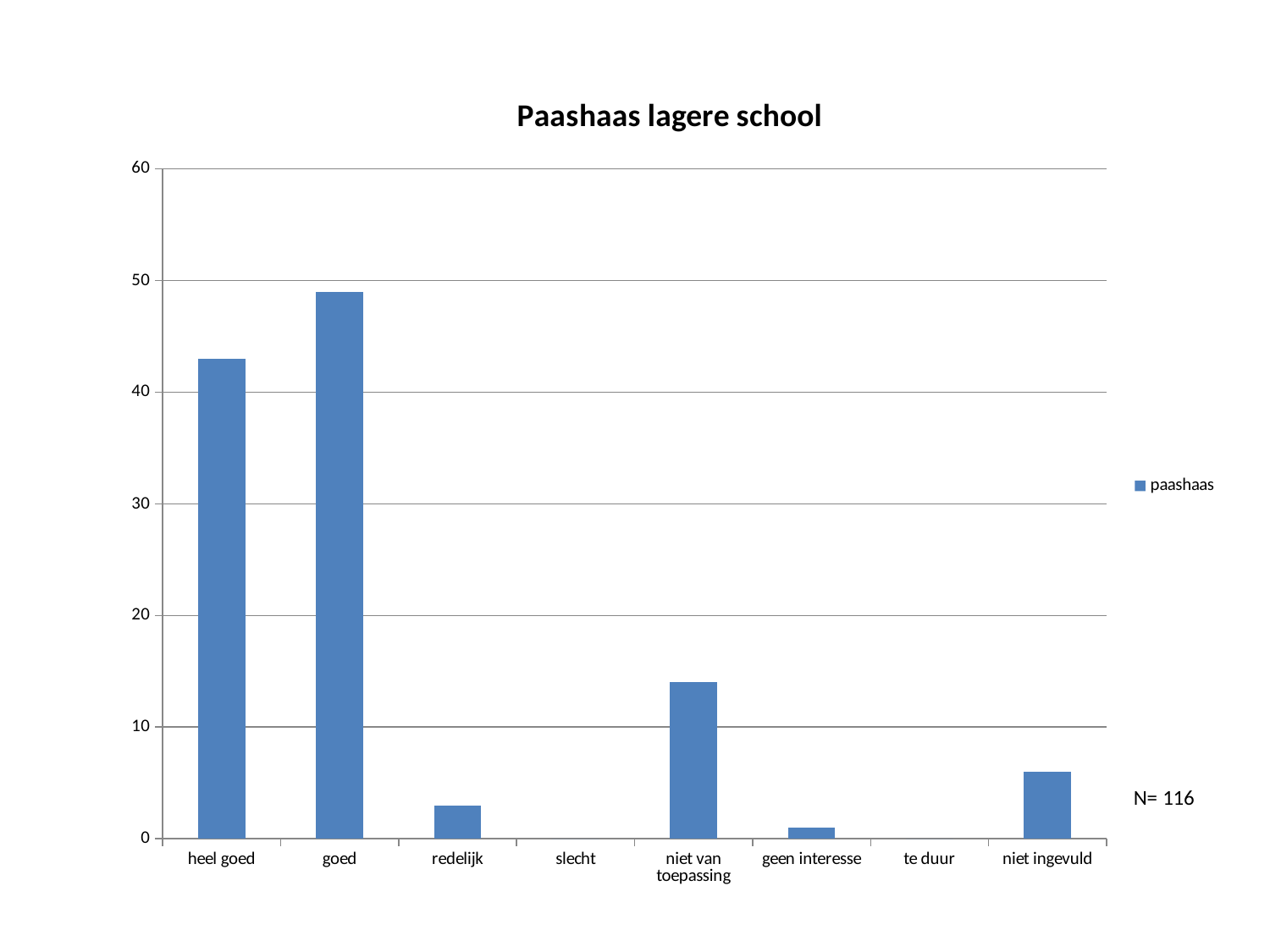
Is the value for goed greater or less than 50? less How many series does the legend list? 1 Which is larger, the value for heel goed or the value for goed? goed Which category has the highest value? goed Is the value for niet ingevuld greater or less than 10? less What kind of chart is shown on the slide? bar chart How many categories are shown on the x axis? 8 Which is larger, the value for niet van toepassing or the value for niet ingevuld? niet van toepassing What is the title of the chart? Paashaas lagere school What is the name of the series shown in the legend? paashaas Is the value for niet van toepassing greater or less than 10? greater